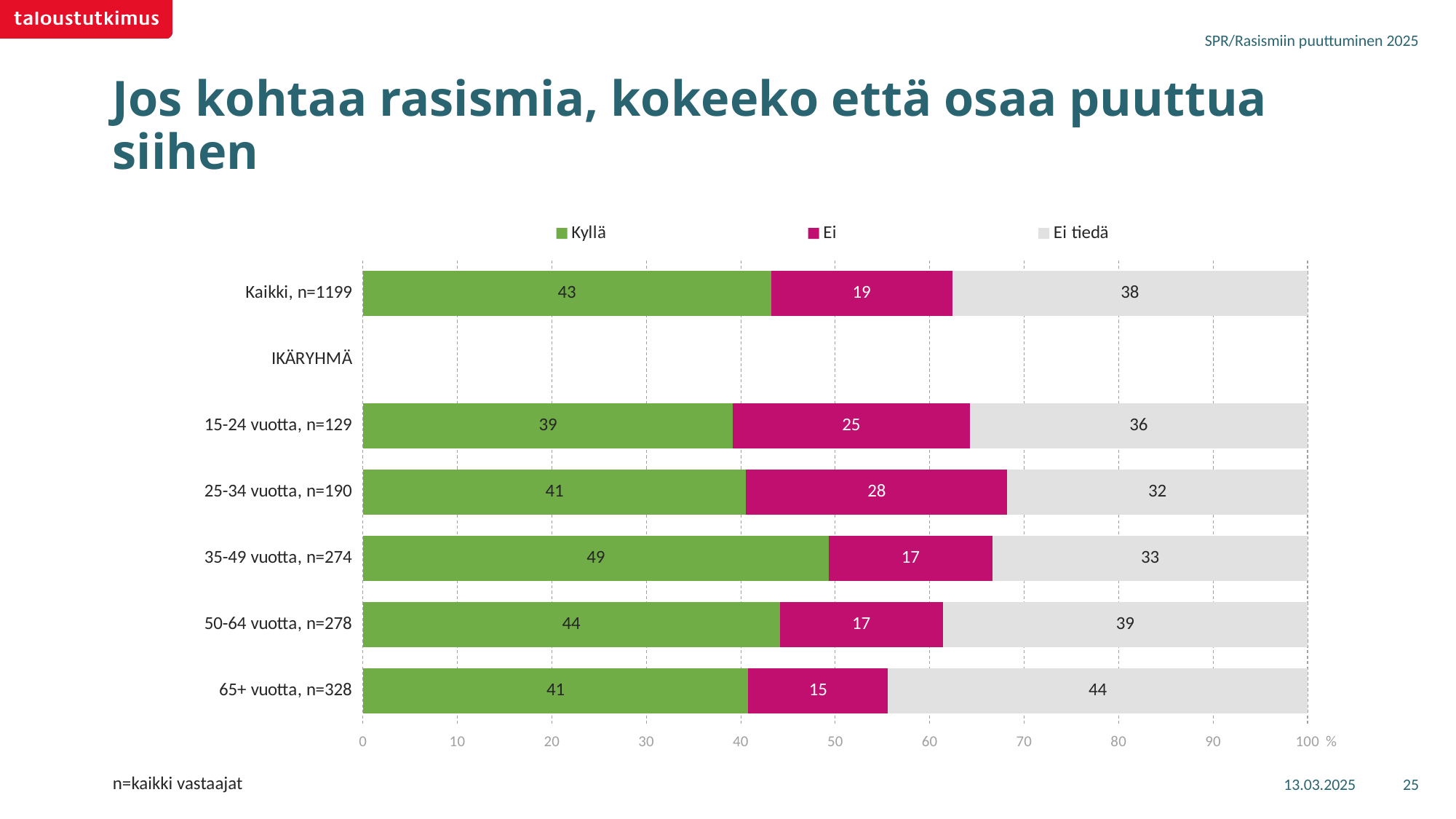
How many bars with data are plotted in the chart? 6 What kind of chart is shown on the slide? Stacked bar chart Which age group has the highest Kyllä value? 35-49 vuotta, n=274 What is the total of the stacked bar for 50-64 vuotta, n=278? 100 What is the Kyllä value for 35-49 vuotta, n=274? 49 What is the Ei value for 25-34 vuotta, n=190? 28 Which category has the lowest Ei value? 65+ vuotta, n=328 How many series does the legend list? 3 Which is larger, the Ei tiedä value for 65+ vuotta, n=328 or for 25-34 vuotta, n=190? 65+ vuotta, n=328 What is the difference between the Ei values for 15-24 vuotta, n=129 and 65+ vuotta, n=328? 10 Which legend entry is shown in green? Kyllä What is the Ei tiedä value for Kaikki, n=1199? 38